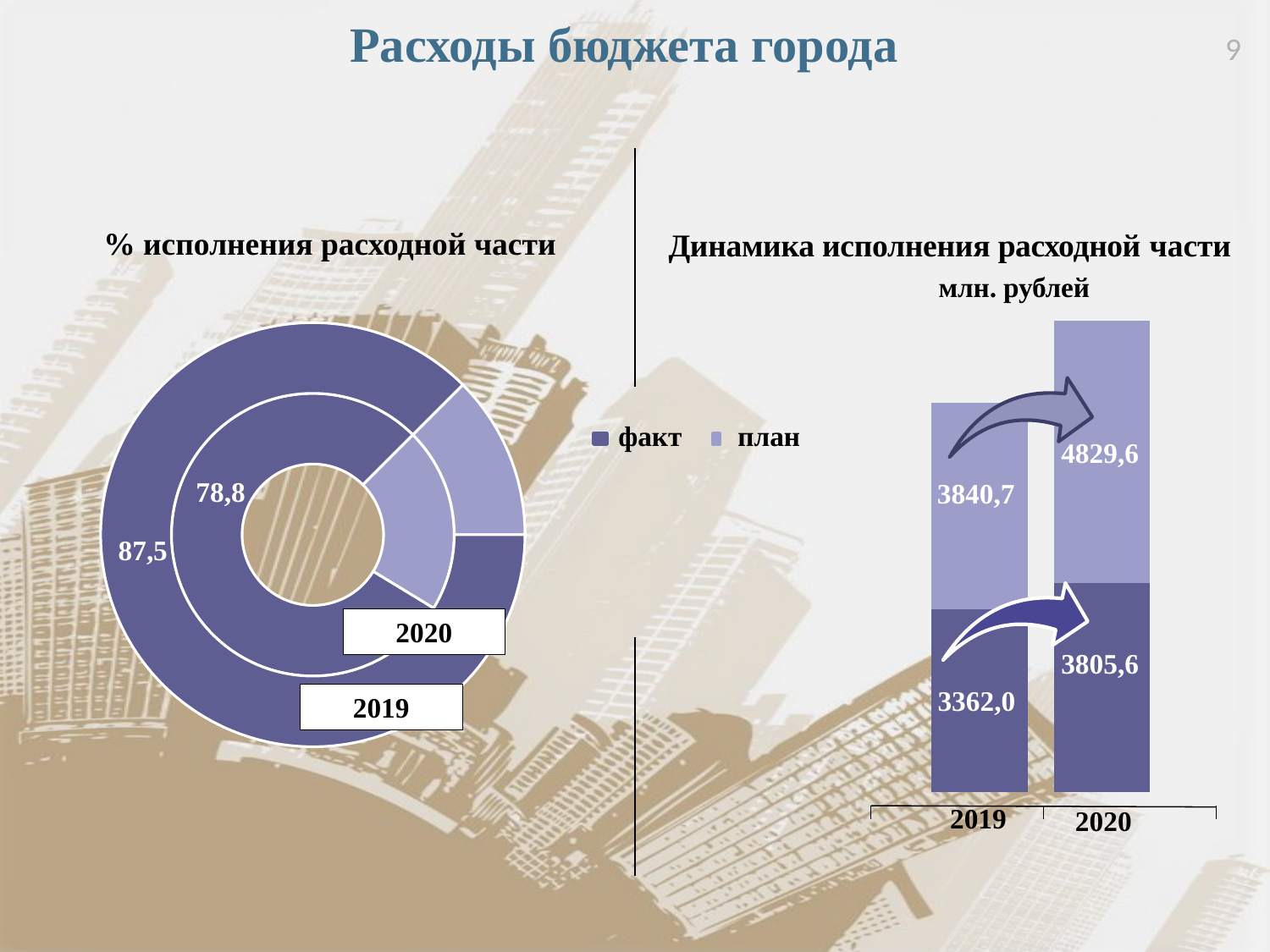
In the chart titled "Динамика исполнения расходной части", what is the план value for 2019? 3840,7 In the chart titled "% исполнения расходной части", which year has the higher value, 2019 or 2020? 2019 In the chart titled "Динамика исполнения расходной части", what is the difference between the план and факт values for 2020? 1024,0 In the chart titled "% исполнения расходной части", what is the value shown for 2019? 87,5 In the chart titled "Динамика исполнения расходной части", does the факт value rise or fall from 2019 to 2020? rise In the chart titled "Динамика исполнения расходной части", what is the план value for 2020? 4829,6 In the chart titled "% исполнения расходной части", what is the difference between the 2019 and 2020 values? 8,7 In the chart titled "% исполнения расходной части", what is the value shown for 2020? 78,8 How many series does the legend list for the chart titled "Динамика исполнения расходной части"? 2 What kind of chart is the one titled "% исполнения расходной части"? doughnut chart In the chart titled "Динамика исполнения расходной части", what is the факт value for 2020? 3805,6 What unit is stated under the title of the chart "Динамика исполнения расходной части"? млн. рублей